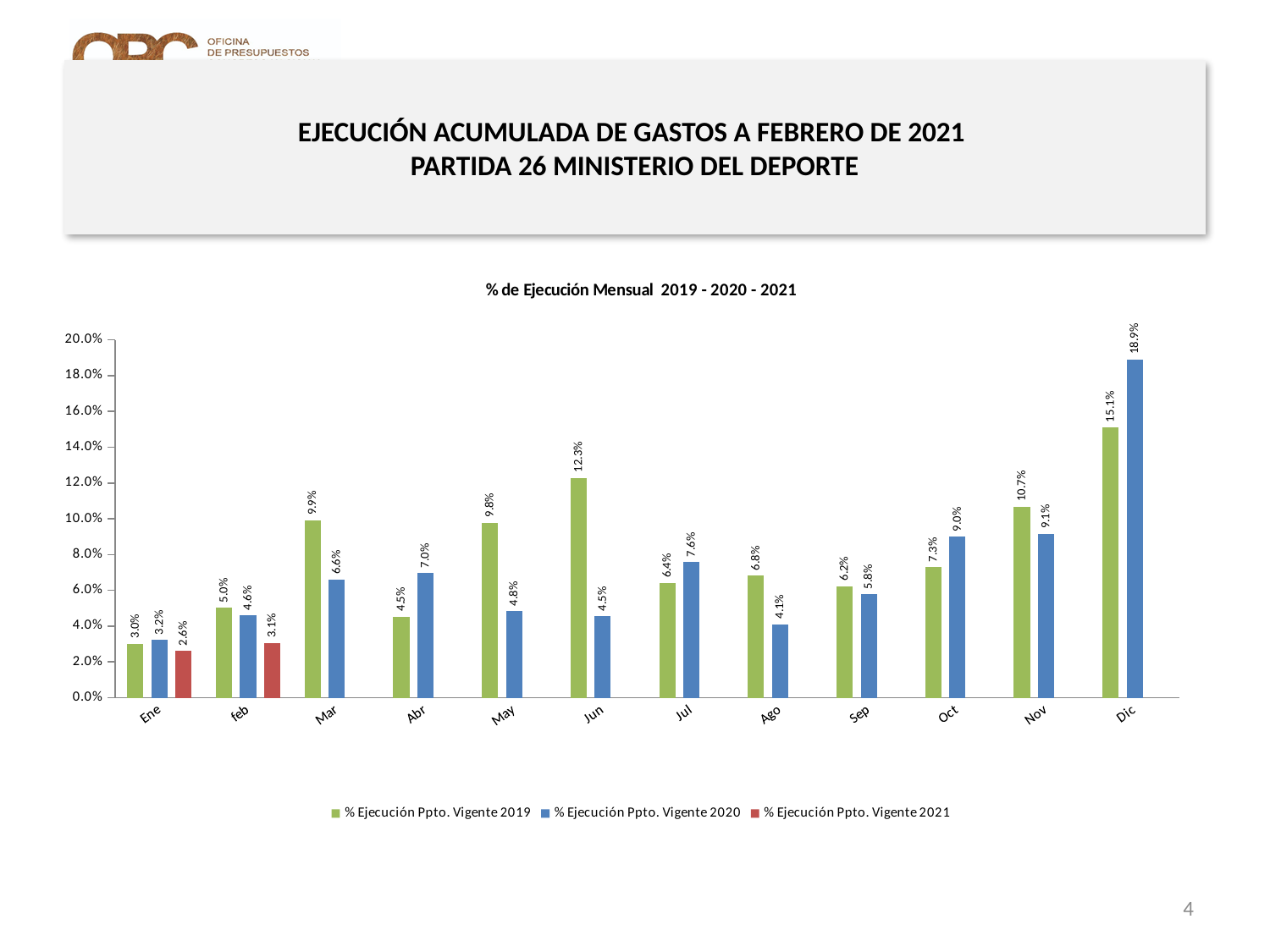
How many series does the legend list? 3 What is the value for % Ejecución Ppto. Vigente 2020 in Dic? 18.9% How many months are shown on the x axis? 12 What kind of chart is shown on the slide? Bar chart What is the value for % Ejecución Ppto. Vigente 2019 in Jun? 12.3% Which is larger in May: the 2019 value or the 2020 value? 2019 value (9.8%) What is the value for % Ejecución Ppto. Vigente 2021 in feb? 3.1% What is the difference between the 2020 and 2019 values in Dic? 3.8% What is the title of the chart? % de Ejecución Mensual 2019 - 2020 - 2021 Which month has the lowest value for % Ejecución Ppto. Vigente 2020? Ene Which month has the highest value for % Ejecución Ppto. Vigente 2019? Dic Is the value for % Ejecución Ppto. Vigente 2019 in Nov greater or less than 10.0%? greater